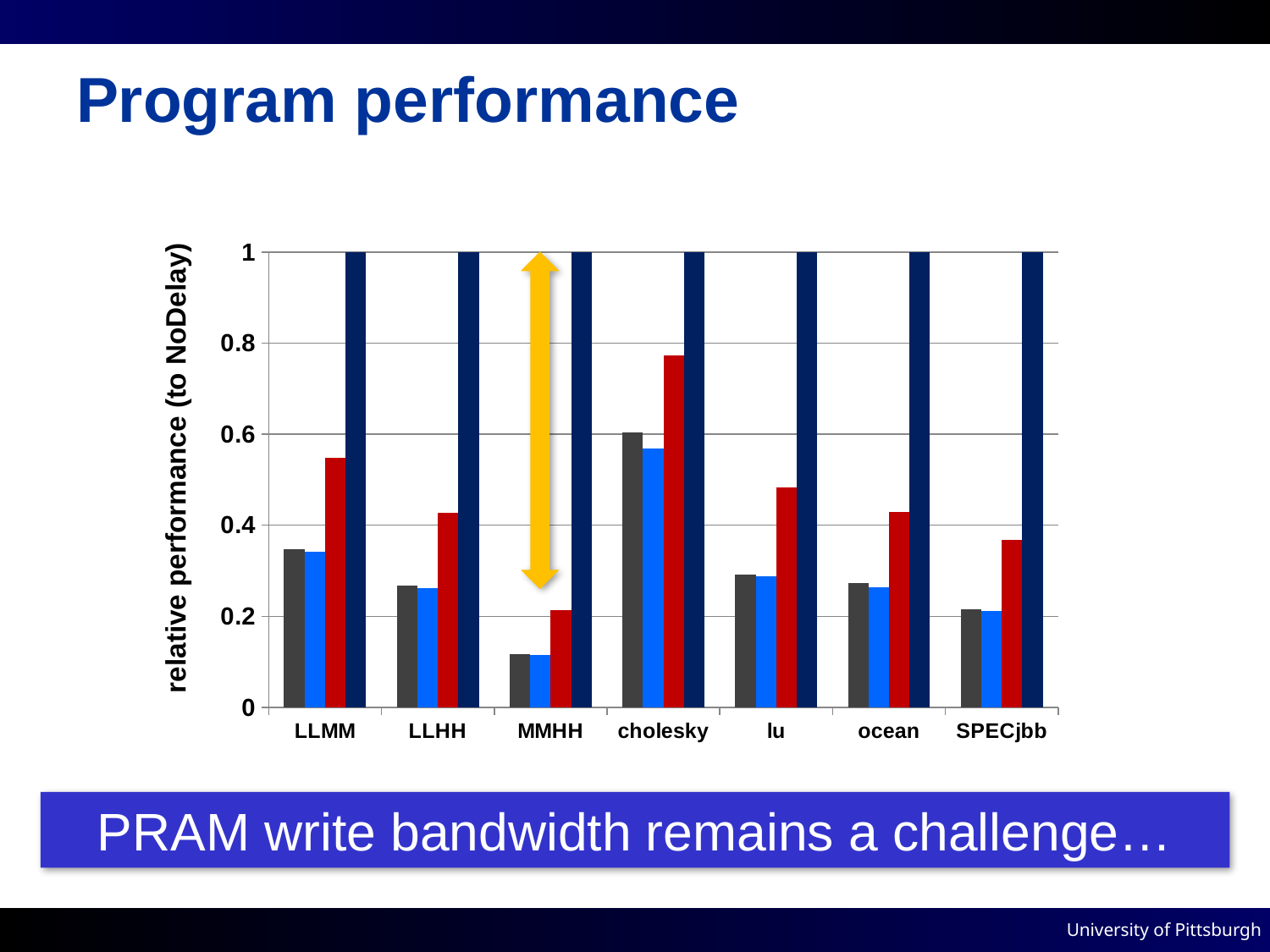
Is the value of the red bar for SPECjbb greater or less than 0.4? less Which category has the lowest red bar? MMHH What kind of chart is shown on the slide? bar chart Which category has the highest red bar? cholesky How many categories are shown on the x axis of the chart? 7 What is the label of the y axis? relative performance (to NoDelay) Is the value of the dark gray bar for MMHH greater or less than 0.2? less What is the value of the dark navy bar for cholesky? 1 How many bars are plotted for each category in the chart? 4 Which category has the lowest dark gray bar? MMHH Is the value of the red bar for cholesky greater or less than 0.6? greater What is the value of the dark navy bar for SPECjbb? 1